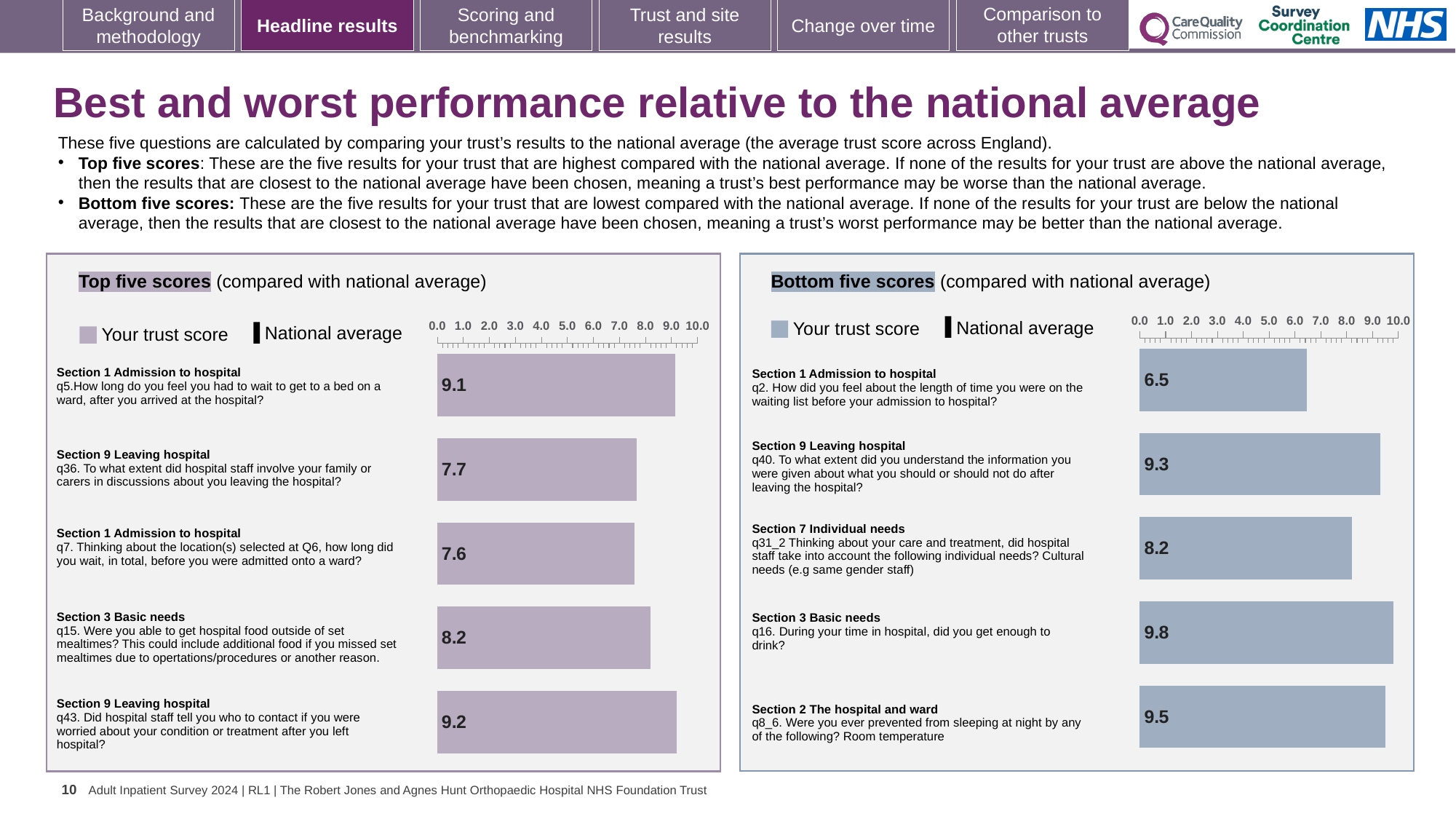
In the Top five scores chart, what is the trust score for q15 (able to get hospital food outside of set mealtimes)? 8.2 In the Top five scores chart, what is the trust score for q5 (how long you had to wait to get to a bed on a ward)? 9.1 In the Bottom five scores chart, what is the trust score for q8_6 (prevented from sleeping at night by room temperature)? 9.5 How many questions are shown in the Bottom five scores chart? 5 In the Bottom five scores chart, what is the trust score for q2 (length of time on the waiting list before admission)? 6.5 In the Top five scores chart, which question has the lowest trust score? q7 In the Bottom five scores chart, which question has the lowest trust score? q2 What kind of chart is the Bottom five scores chart? Bar chart In the Top five scores chart, which has the larger trust score: q36 or q7? q36 In the Top five scores chart, which question has the highest trust score? q43 How many series does the legend of the Top five scores chart list? 2 In the Bottom five scores chart, what is the difference between the highest score (q16) and the lowest score (q2)? 3.3